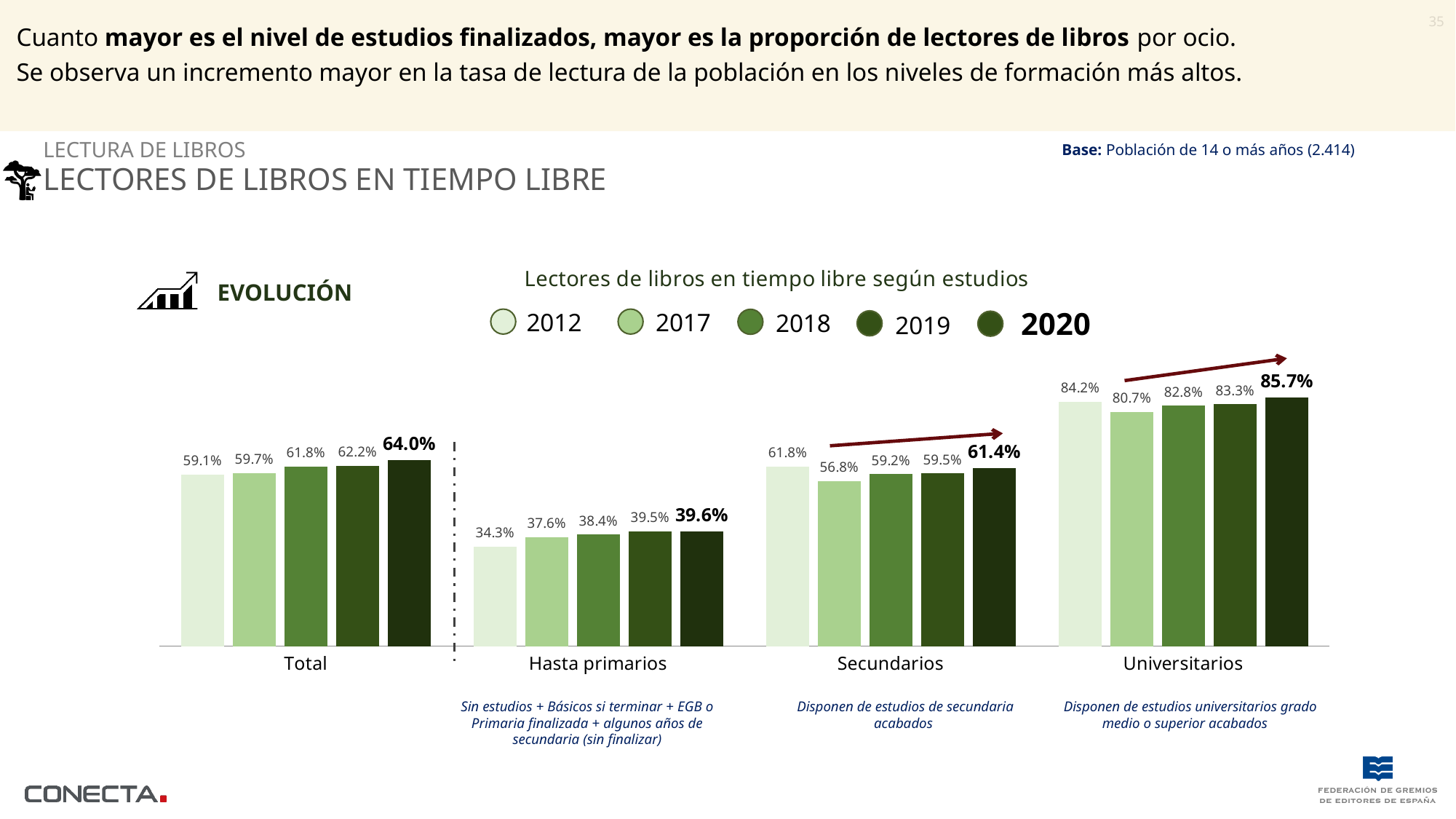
What is the value for Universitarios in 2020? 85.7% Which category has the lowest value in 2012? Hasta primarios What kind of chart is shown? Bar chart How many series does the legend list? 5 What is the value for Hasta primarios in 2012? 34.3% What is the title of the chart? Lectores de libros en tiempo libre según estudios Which category has the highest value in 2020? Universitarios What is the difference between the 2020 and 2012 values for Hasta primarios? 5.3 percentage points How many categories are shown on the x axis? 4 What is the value for Total in 2019? 62.2% Which is larger for Secundarios: the 2012 value or the 2020 value? 2012 What is the value for Secundarios in 2017? 56.8%